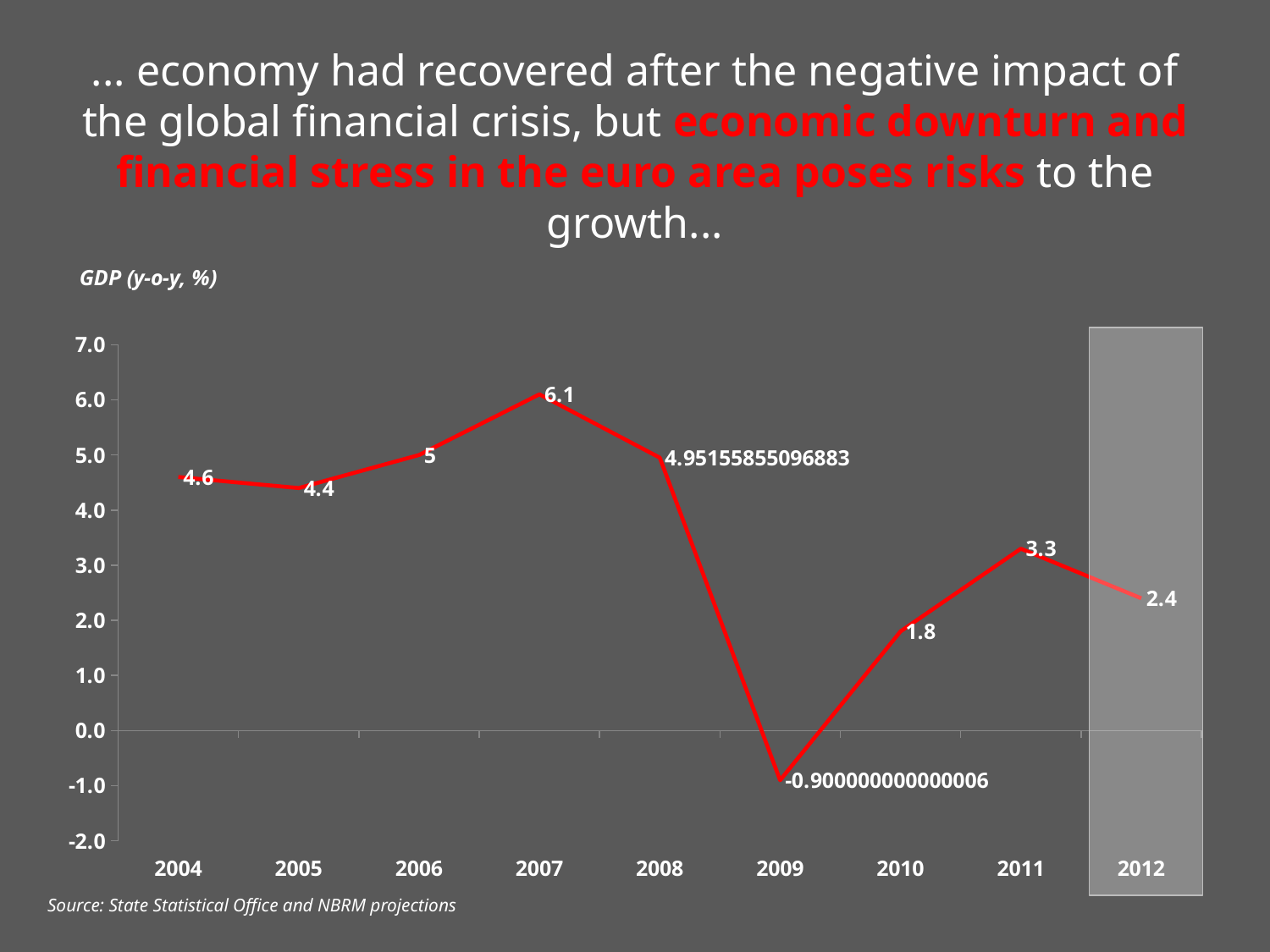
What is the difference between the GDP growth values for 2011 and 2012? 0.9 What is the GDP growth value for 2007? 6.1 What is the difference between the GDP growth values for 2007 and 2004? 1.5 What is the GDP growth value for 2010? 1.8 Which year has the highest GDP growth value? 2007 What is the GDP growth value for 2004? 4.6 Which year has the lowest GDP growth value? 2009 Do the GDP growth values rise or fall from 2009 to 2011? Rise What kind of chart is shown on the slide? Line chart Which year has a larger GDP growth value, 2006 or 2005? 2006 What is the GDP growth value shown for 2012? 2.4 How many years are plotted on the chart? 9